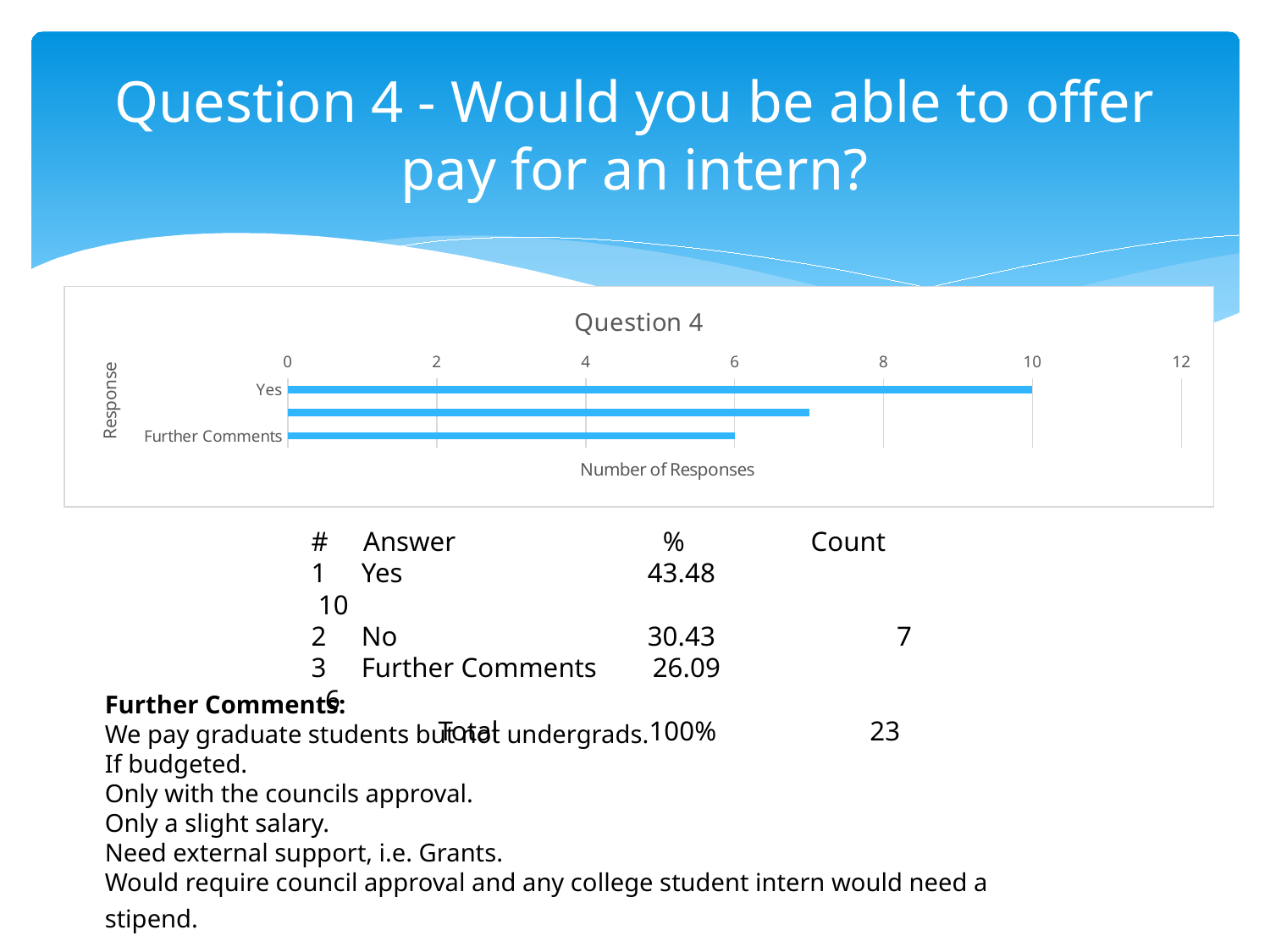
What is the title of the chart? Question 4 What is the number of responses for Yes? 10 What is the difference in number of responses between Yes and Further Comments? 4 Is the value for Yes greater or less than 8? greater How many bars are plotted in the chart? 3 What is the x-axis title of the chart? Number of Responses What is the number of responses for Further Comments? 6 Is the value for Further Comments greater or less than 8? less Which response category has the highest number of responses? Yes Which response category has the lowest number of responses? Further Comments What type of chart is shown on the slide? bar chart Which has more responses, Yes or Further Comments? Yes